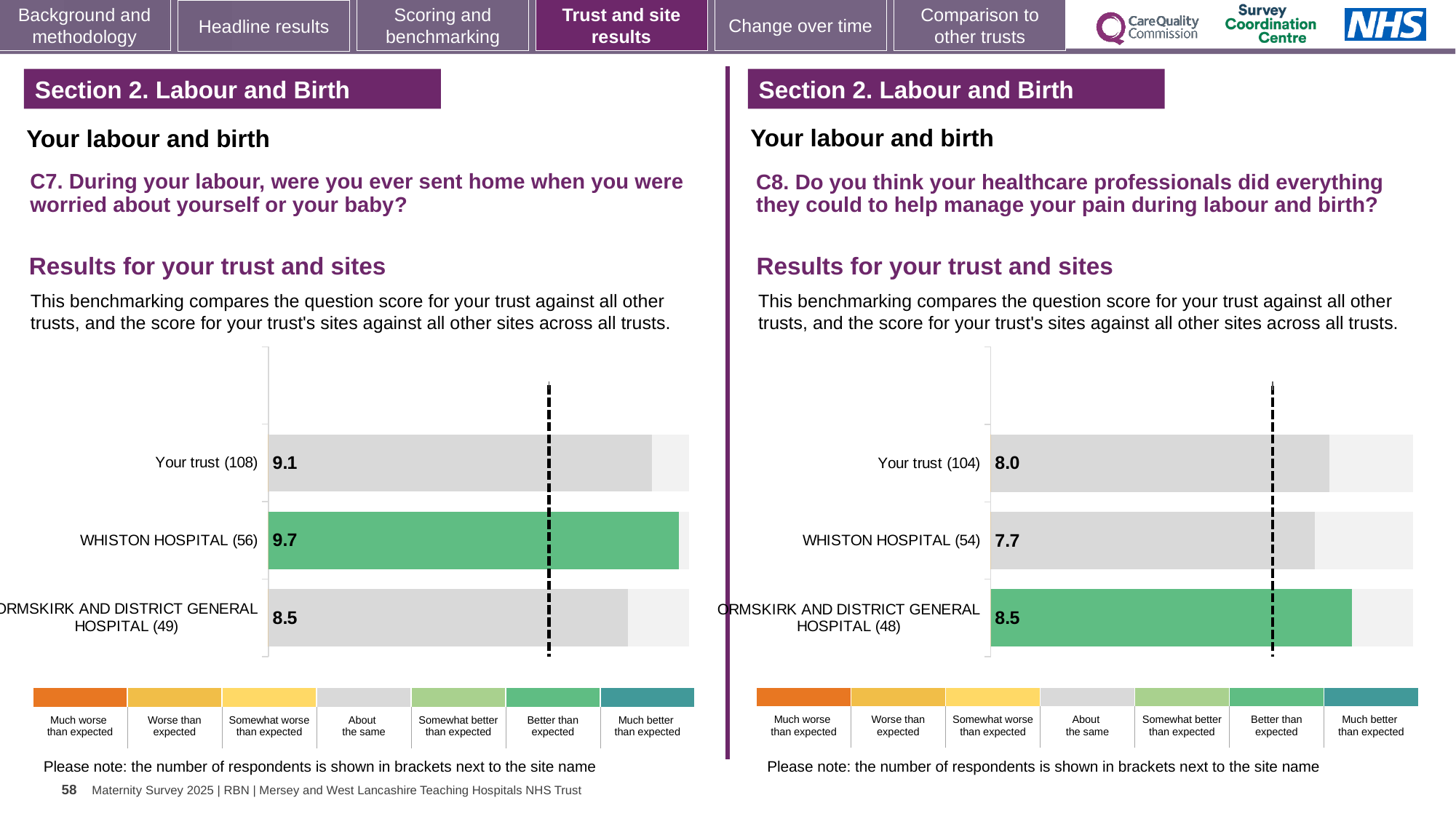
In the C8 chart on the right, which site or trust has the lowest score? WHISTON HOSPITAL In the C8 chart on the right, what is the score for ORMSKIRK AND DISTRICT GENERAL HOSPITAL? 8.5 In the C7 chart on the left, what is the difference between the scores for WHISTON HOSPITAL and ORMSKIRK AND DISTRICT GENERAL HOSPITAL? 1.2 In the C8 chart on the right, which has the larger score, Your trust or WHISTON HOSPITAL? Your trust In the C7 chart on the left, which site or trust has the highest score? WHISTON HOSPITAL In the C7 chart on the left, how many respondents are shown in brackets for Your trust? 108 How many bars are plotted in the C7 chart on the left? 3 In the C7 chart on the left, what is the score for WHISTON HOSPITAL? 9.7 What kind of chart is used in the C8 chart on the right? Bar chart In the C8 chart on the right, what is the score for WHISTON HOSPITAL? 7.7 In the C7 chart on the left, what is the score for Your trust? 9.1 In the C8 chart on the right, what is the difference between the scores for ORMSKIRK AND DISTRICT GENERAL HOSPITAL and Your trust? 0.5